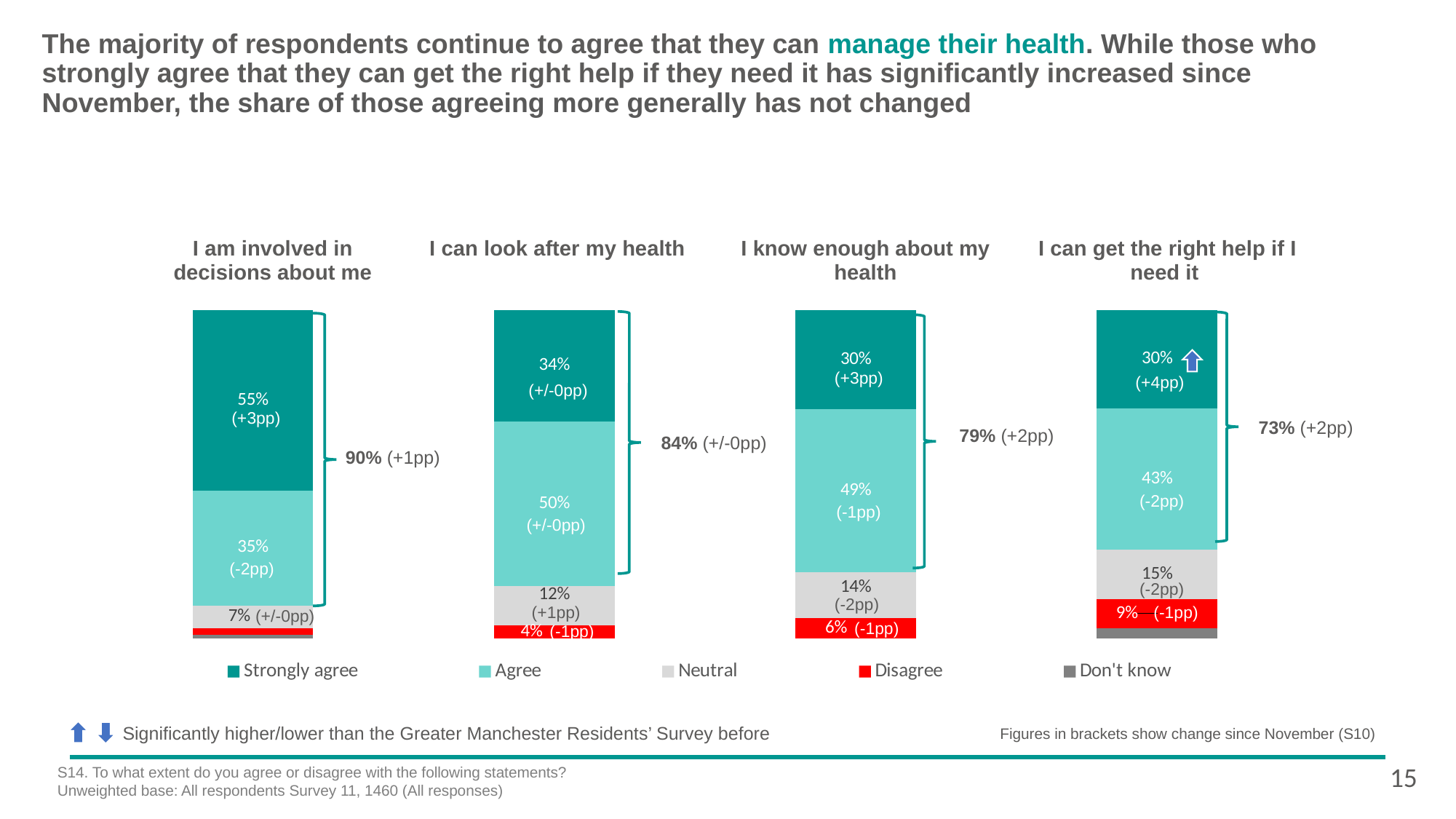
What is the Neutral share for "I know enough about my health"? 14% What is the Agree share for "I can look after my health"? 50% What is the Disagree share for "I can get the right help if I need it"? 9% What kind of chart is shown on the slide? Stacked bar chart Which is larger: the Agree share for "I know enough about my health" or for "I can get the right help if I need it"? I know enough about my health How many response categories does the legend list? 5 What is the combined agree (strongly agree plus agree) figure shown for "I can get the right help if I need it"? 73% Which statement has the highest combined agree figure? I am involved in decisions about me What percentage of respondents strongly agree with "I am involved in decisions about me"? 55% What is the difference between the Strongly agree shares for "I am involved in decisions about me" and "I can look after my health"? 21 percentage points How many statements are shown in the chart? 4 Which statement has the lowest Strongly agree share? I know enough about my health and I can get the right help if I need it (both 30%)